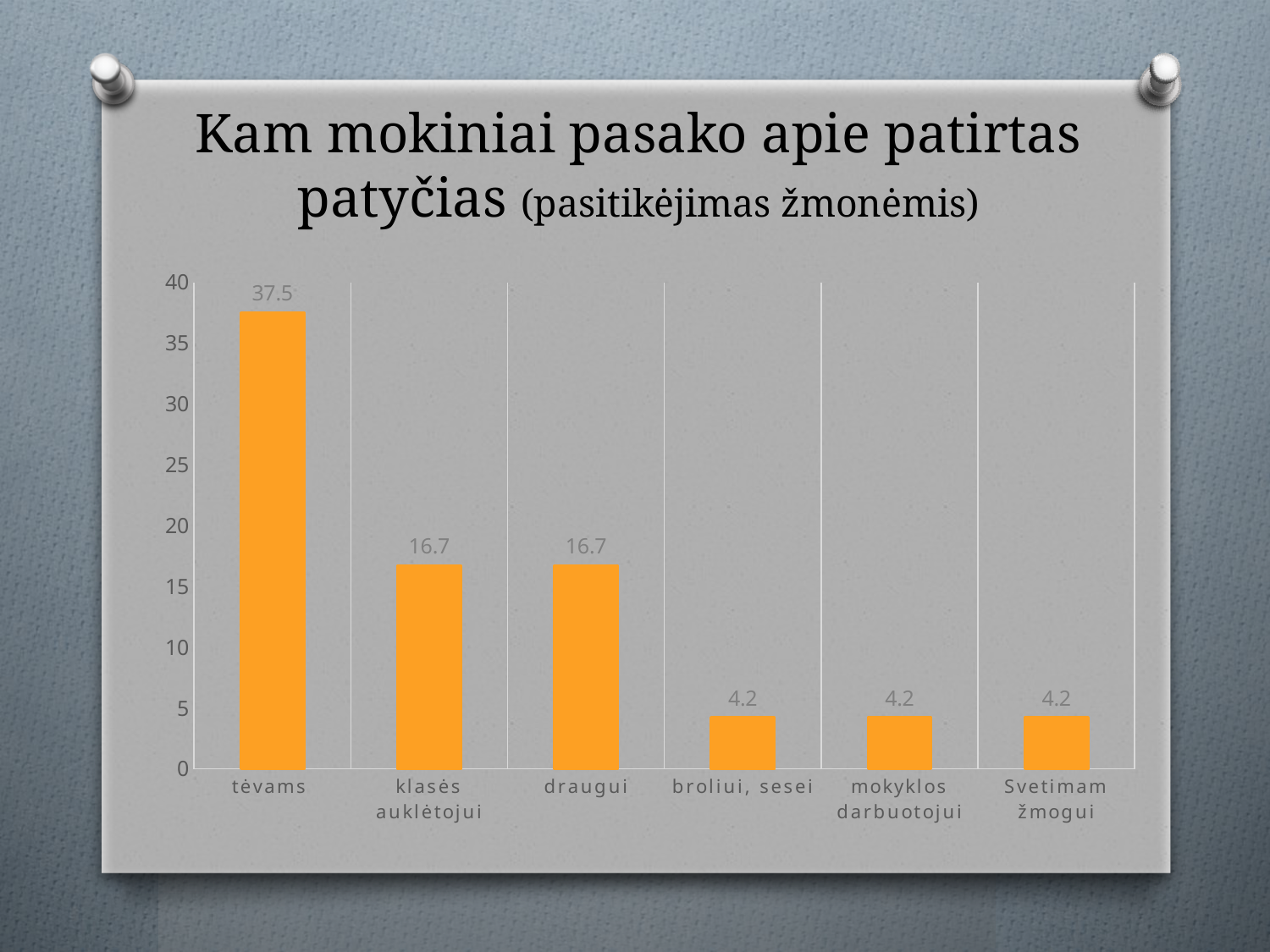
Is the value for tėvams greater or less than 35? greater What kind of chart is shown on the slide? bar chart What is the value for klasės auklėtojui? 16.7 Which category has the highest value? tėvams What is the value for broliui, sesei? 4.2 What is the difference between the values for tėvams and draugui? 20.8 Which is larger, the value for draugui or the value for broliui, sesei? draugui What colour are the bars in the chart? orange How many categories are shown on the x axis? 6 What is the value for tėvams? 37.5 What is the difference between the values for klasės auklėtojui and mokyklos darbuotojui? 12.5 What is the value for Svetimam žmogui? 4.2